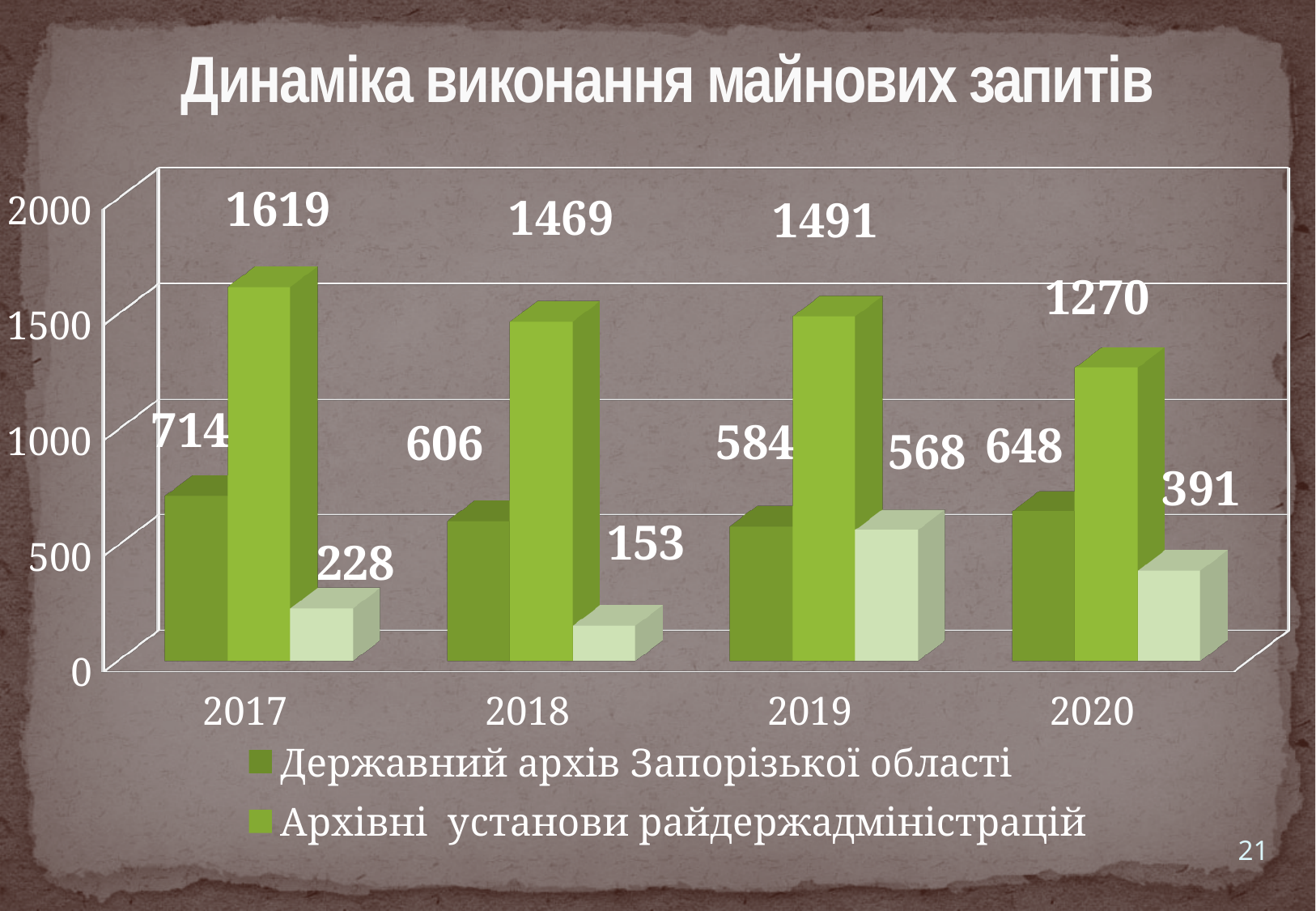
What is the value for Державний архів Запорізької області in 2017? 714 What is the value for Архівні установи райдержадміністрацій in 2019? 1491 In which year is the value for Державний архів Запорізької області lowest? 2019 How many series does the legend list? 2 What is the difference between the Архівні установи райдержадміністрацій values for 2017 and 2020? 349 How many years are shown on the x axis? 4 Which is larger: the Державний архів Запорізької області value in 2018 or in 2020? 2020 In which year is the value for Архівні установи райдержадміністрацій highest? 2017 What is the value for Державний архів Запорізької області in 2020? 648 Is the value for Архівні установи райдержадміністрацій in 2020 greater or less than 1500? less What kind of chart is shown on the slide? bar chart What is the title of the chart? Динаміка виконання майнових запитів